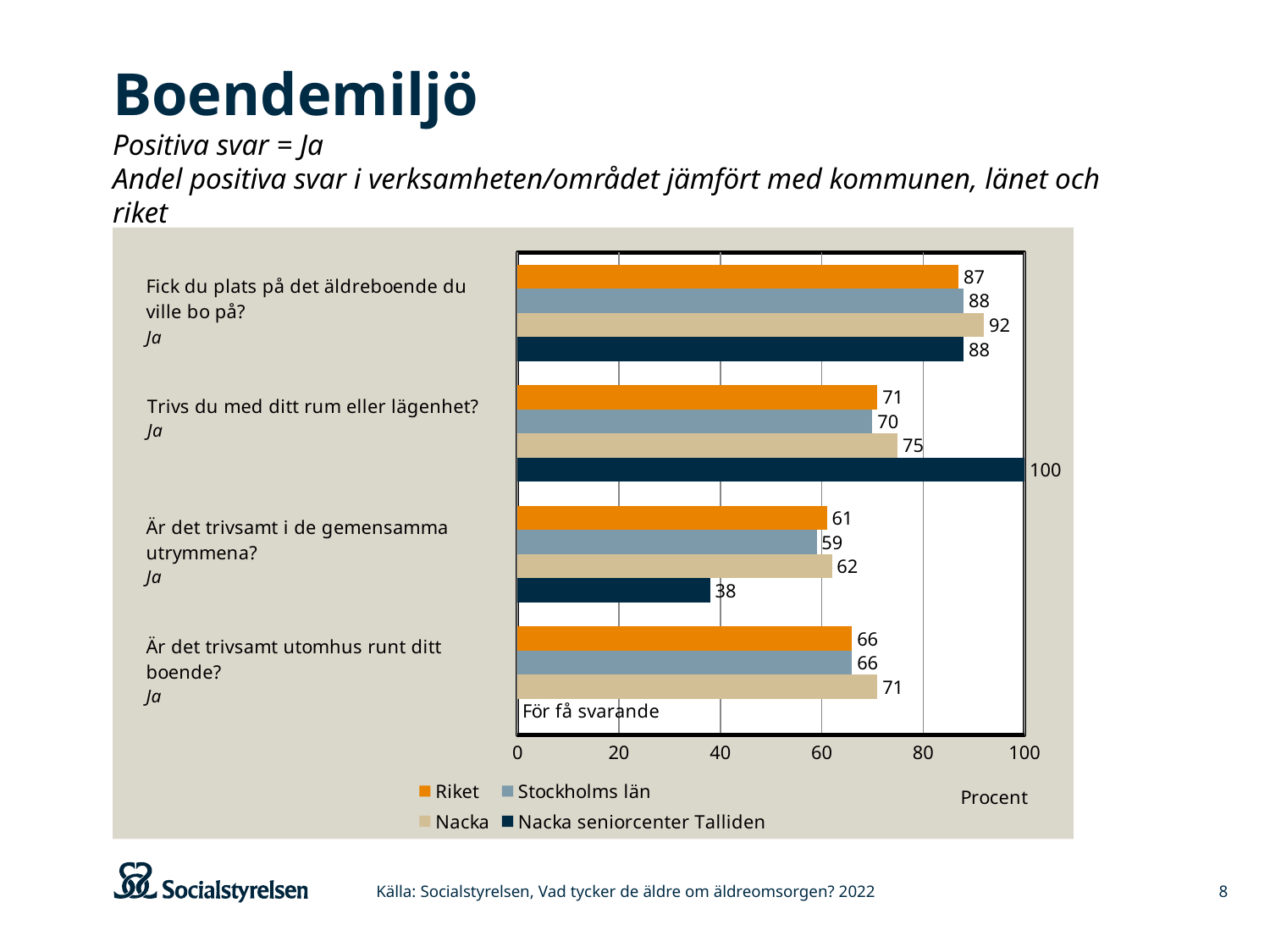
Which series has the lowest value for "Är det trivsamt i de gemensamma utrymmena?" Nacka seniorcenter Tallidén How many question categories are shown on the chart? 4 What value is shown for Riket for "Är det trivsamt utomhus runt ditt boende?" 66 What is the difference between the Nacka value and the Riket value for "Trivs du med ditt rum eller lägenhet?" 4 What kind of chart is shown on the slide? Bar chart What value is shown for Stockholms län for "Är det trivsamt i de gemensamma utrymmena?" 59 What value is shown for Nacka for "Fick du plats på det äldreboende du ville bo på?" 92 How many series does the legend list? 4 What text is shown in place of the Nacka seniorcenter Tallidén bar for "Är det trivsamt utomhus runt ditt boende?" För få svarande Which series has the highest value for "Trivs du med ditt rum eller lägenhet?" Nacka seniorcenter Tallidén What value is shown for Nacka seniorcenter Tallidén for "Trivs du med ditt rum eller lägenhet?" 100 For "Är det trivsamt i de gemensamma utrymmena?", which is larger: the Riket value or the Nacka seniorcenter Tallidén value? Riket